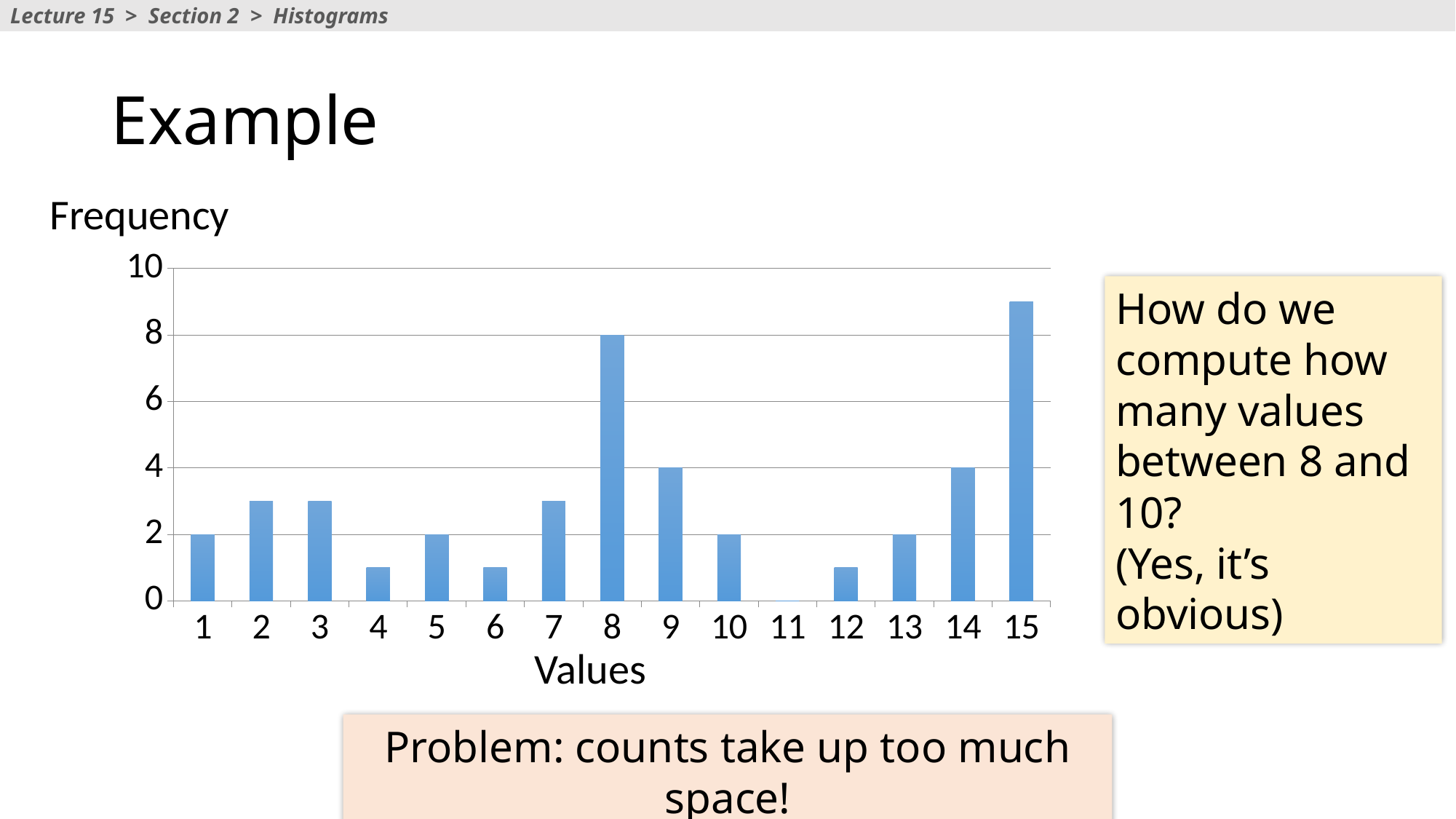
Which value has the lowest frequency? 11 What is the frequency for value 11? 0 Is the frequency for value 15 greater or less than 8? greater Is the frequency for value 4 greater or less than 2? less What is the frequency for value 9? 4 What is the frequency for value 8? 8 What kind of chart is shown on the slide? bar chart What is the label of the x axis? Values How many categories are shown on the x axis of the chart? 15 What is the difference between the frequency for value 8 and the frequency for value 9? 4 What is the frequency for value 14? 4 Which value has the highest frequency? 15